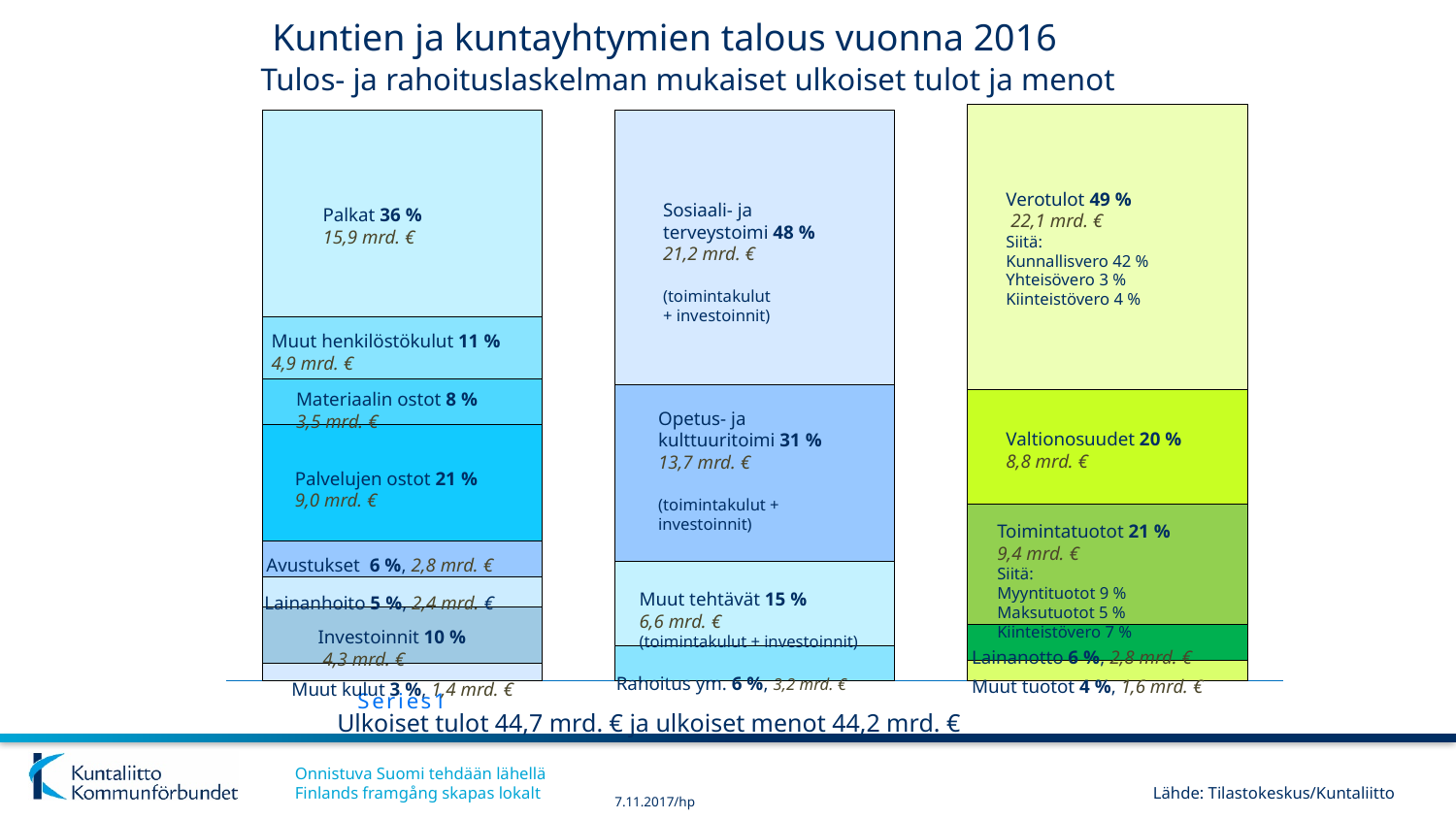
What is the title of the chart? Kuntien ja kuntayhtymien talous vuonna 2016 What is the total of ulkoiset tulot stated on the slide? 44,7 mrd. € Which is larger in the left bar, Palvelujen ostot or Investoinnit? Palvelujen ostot How many segments does the middle bar have? 4 How many mrd. € is Valtionosuudet in the right bar? 8,8 mrd. € What kind of chart is shown on the slide? stacked bar chart What share of expenses is Palkat in the left bar? 36 % How many mrd. € is Sosiaali- ja terveystoimi in the middle bar? 21,2 mrd. € Which segment is the largest in the left bar? Palkat What share of income is Verotulot in the right bar? 49 % Which segment is the smallest in the right bar? Muut tuotot What is the difference in mrd. € between Sosiaali- ja terveystoimi and Opetus- ja kulttuuritoimi in the middle bar? 7,5 mrd. €